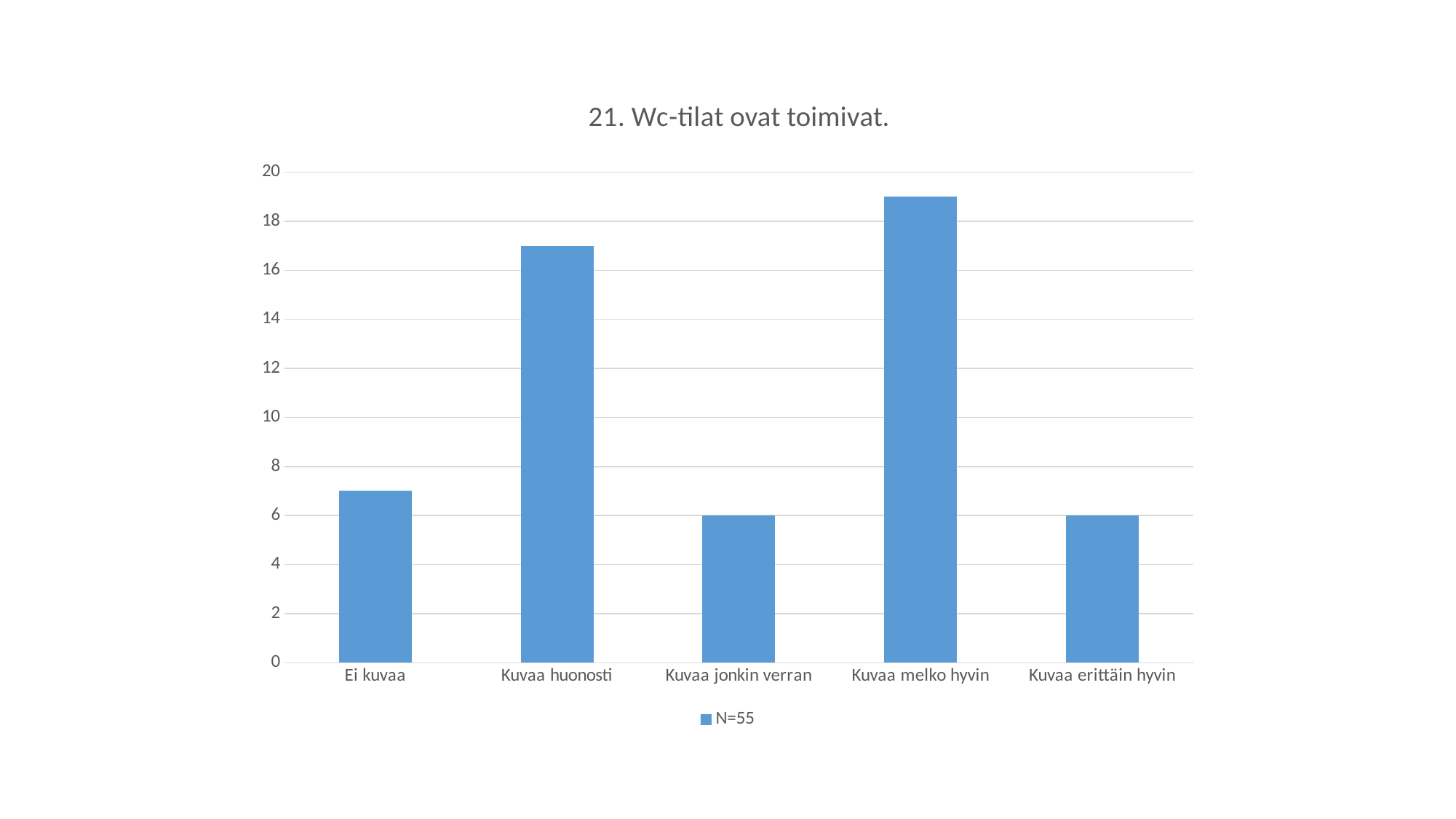
What kind of chart is shown on the slide? bar chart What is the value for Kuvaa erittäin hyvin? 6 Is the value for Kuvaa huonosti greater or less than 16? greater What is the legend entry for the series? N=55 Which category has the highest value? Kuvaa melko hyvin Is the value for Kuvaa melko hyvin greater or less than 18? greater How many series does the legend list? 1 What is the title of the chart? 21. Wc-tilat ovat toimivat. Which is larger, the value for Kuvaa huonosti or the value for Ei kuvaa? Kuvaa huonosti What is the value for Kuvaa jonkin verran? 6 How many categories are shown on the x axis? 5 Is the value for Ei kuvaa greater or less than 8? less